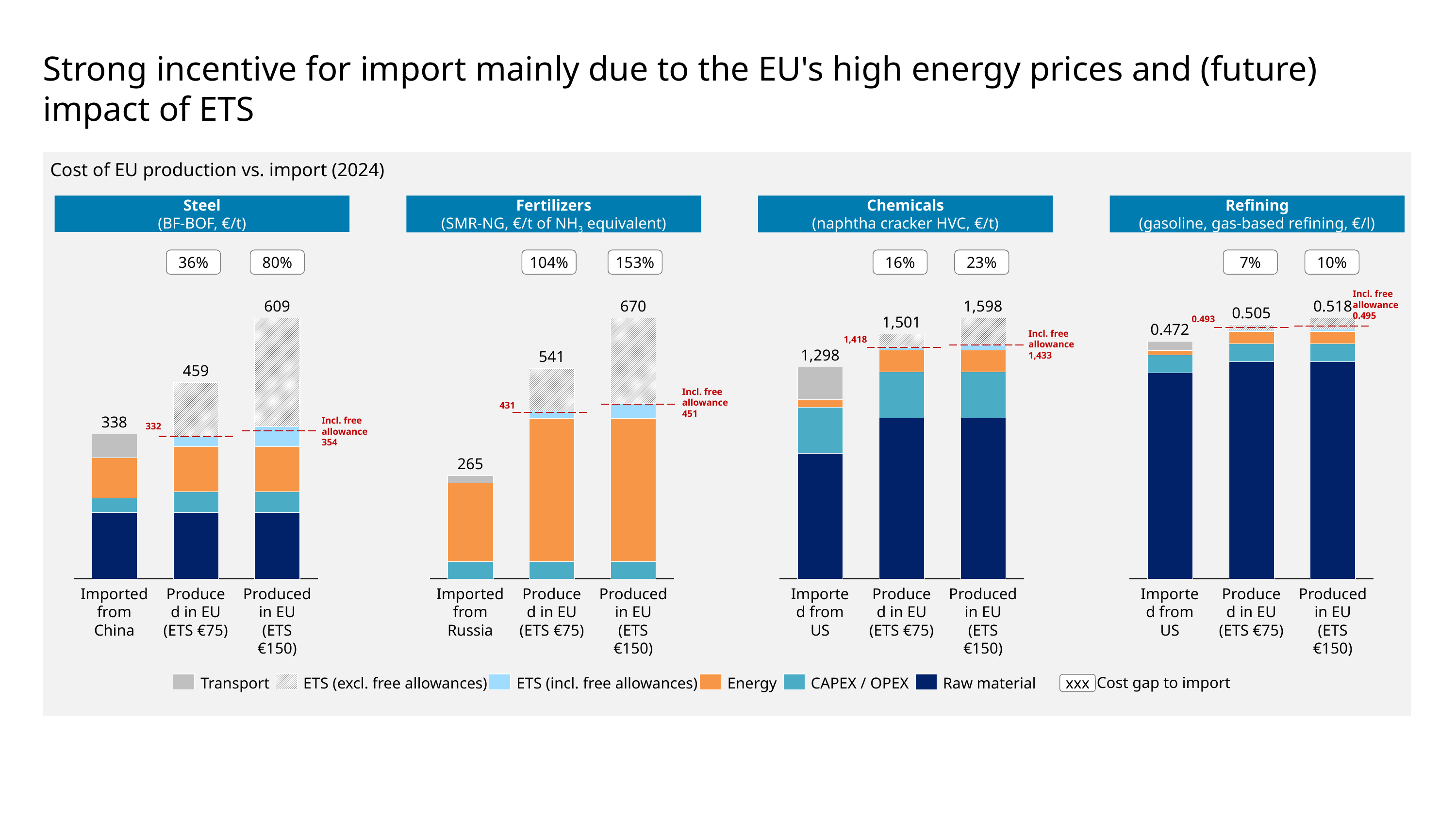
In the Refining chart, what is the total cost labelled for 'Imported from US'? 0.472 How many bars does the Refining chart contain? 3 In the Steel chart, what is the total cost labelled for the bar 'Imported from China'? 338 In the Chemicals chart, what is the total cost labelled for 'Produced in EU (ETS €75)'? 1,501 In the Fertilizers chart, what cost gap to import is shown for 'Produced in EU (ETS €75)'? 104% What kind of chart is used for the Steel panel? Stacked bar chart In the Chemicals chart, which bar has the highest total cost? Produced in EU (ETS €150) In the Chemicals chart, what is the difference between the total for 'Produced in EU (ETS €150)' and 'Imported from US'? 300 In the Fertilizers chart, what is the total cost labelled for 'Produced in EU (ETS €150)'? 670 In the Fertilizers chart, which bar has the lowest total cost? Imported from Russia In the Steel chart, what is the difference between the total for 'Produced in EU (ETS €150)' and 'Imported from China'? 271 In the Steel chart, what cost gap to import is shown for 'Produced in EU (ETS €150)'? 80%